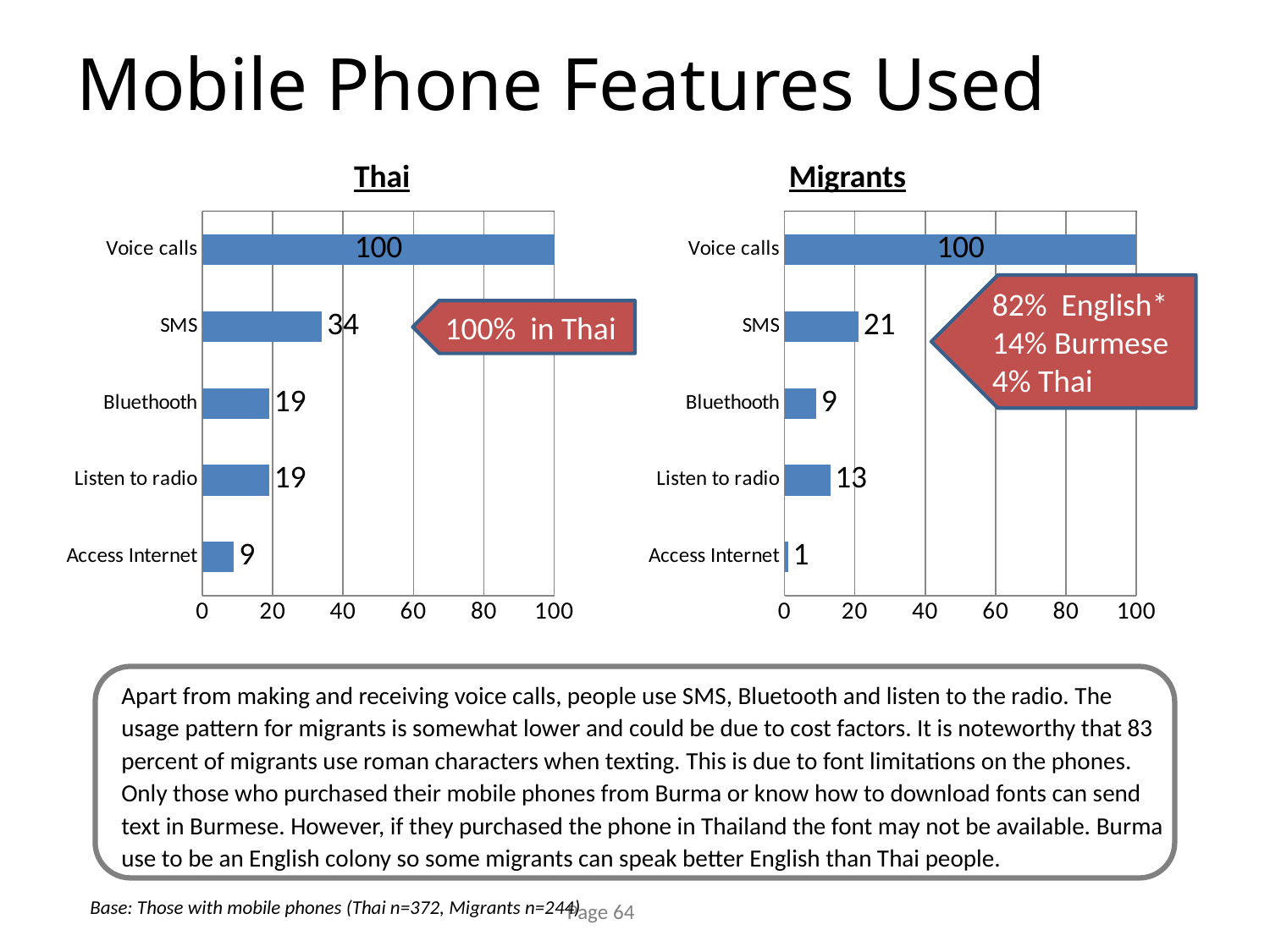
In the Thai chart, what is the value for SMS? 34 Which is larger: Bluetooth in the Thai chart or Bluetooth in the Migrants chart? Thai What kind of chart is the Migrants chart? bar chart In the Thai chart, what is the difference between SMS and Bluetooth? 15 How many categories are shown in the Thai chart? 5 What is the difference between the SMS values in the Thai chart and the Migrants chart? 13 In the Migrants chart, what is the value for Listen to radio? 13 In the Migrants chart, what is the value for Access Internet? 1 In the Migrants chart, which category has the highest value? Voice calls In the Migrants chart, is the value for SMS greater or less than 40? less In the Thai chart, which category has the lowest value? Access Internet What is the title of the chart on the left? Thai